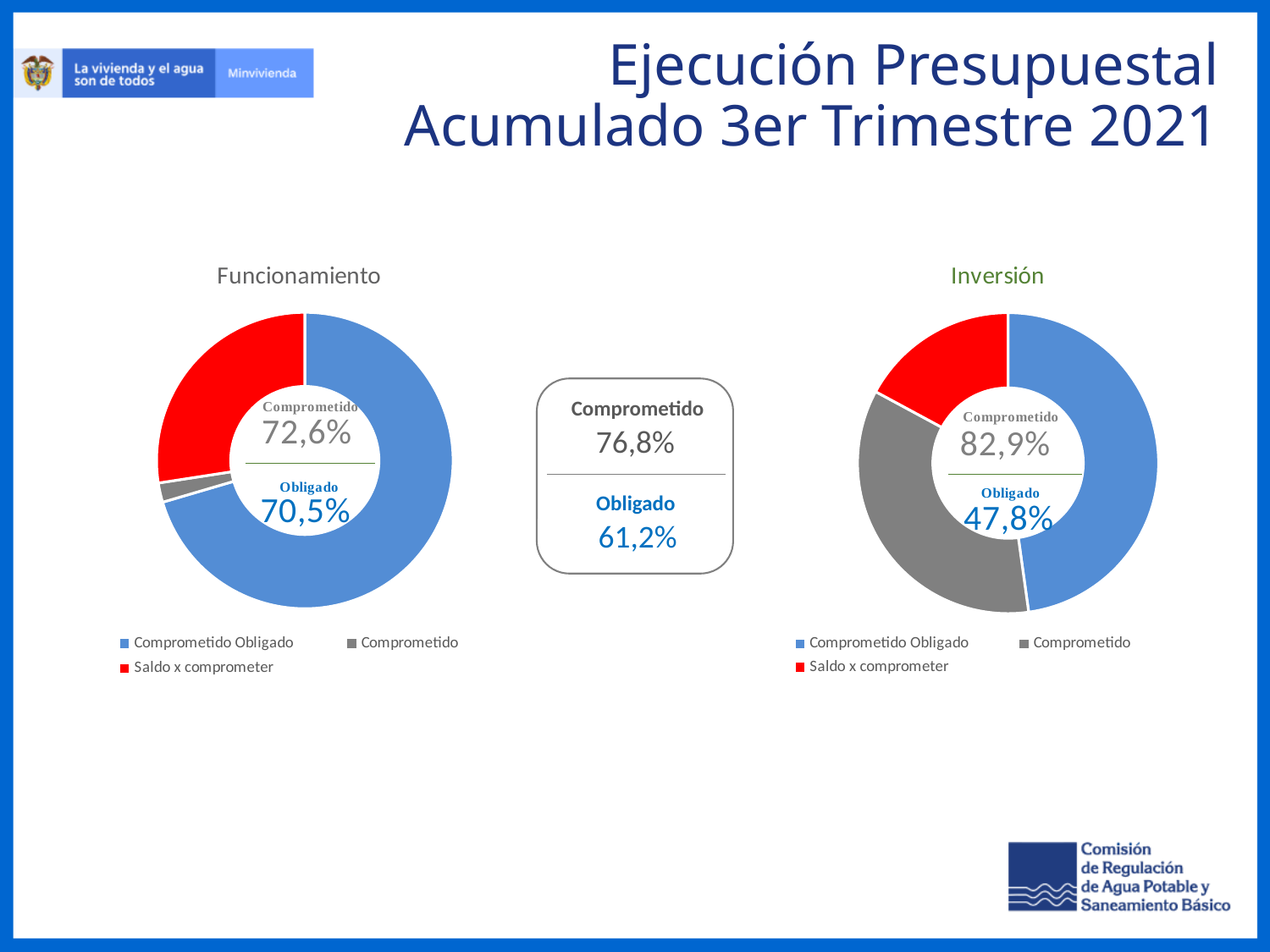
In the Inversión chart, what is the difference between the Comprometido and Obligado percentages shown in the centre? 35,1 percentage points In the Inversión chart, what colour represents Saldo x comprometer? Red How many categories does the legend of the Funcionamiento chart list? 3 In the Inversión chart, what Comprometido percentage is shown in the centre? 82,9% In the Funcionamiento chart, what Obligado percentage is shown in the centre? 70,5% In the Funcionamiento chart, what Comprometido percentage is shown in the centre? 72,6% In the Inversión chart, which category has the largest slice? Comprometido Obligado By how many percentage points does the Comprometido value in the Inversión chart exceed the Comprometido value in the Funcionamiento chart? 10,3 percentage points In the Funcionamiento chart, which category has the smallest slice? Comprometido What kind of chart is used for Funcionamiento and Inversión on this slide? Doughnut (pie) chart In the Inversión chart, what Obligado percentage is shown in the centre? 47,8% Which chart shows the higher Obligado percentage, Funcionamiento or Inversión? Funcionamiento